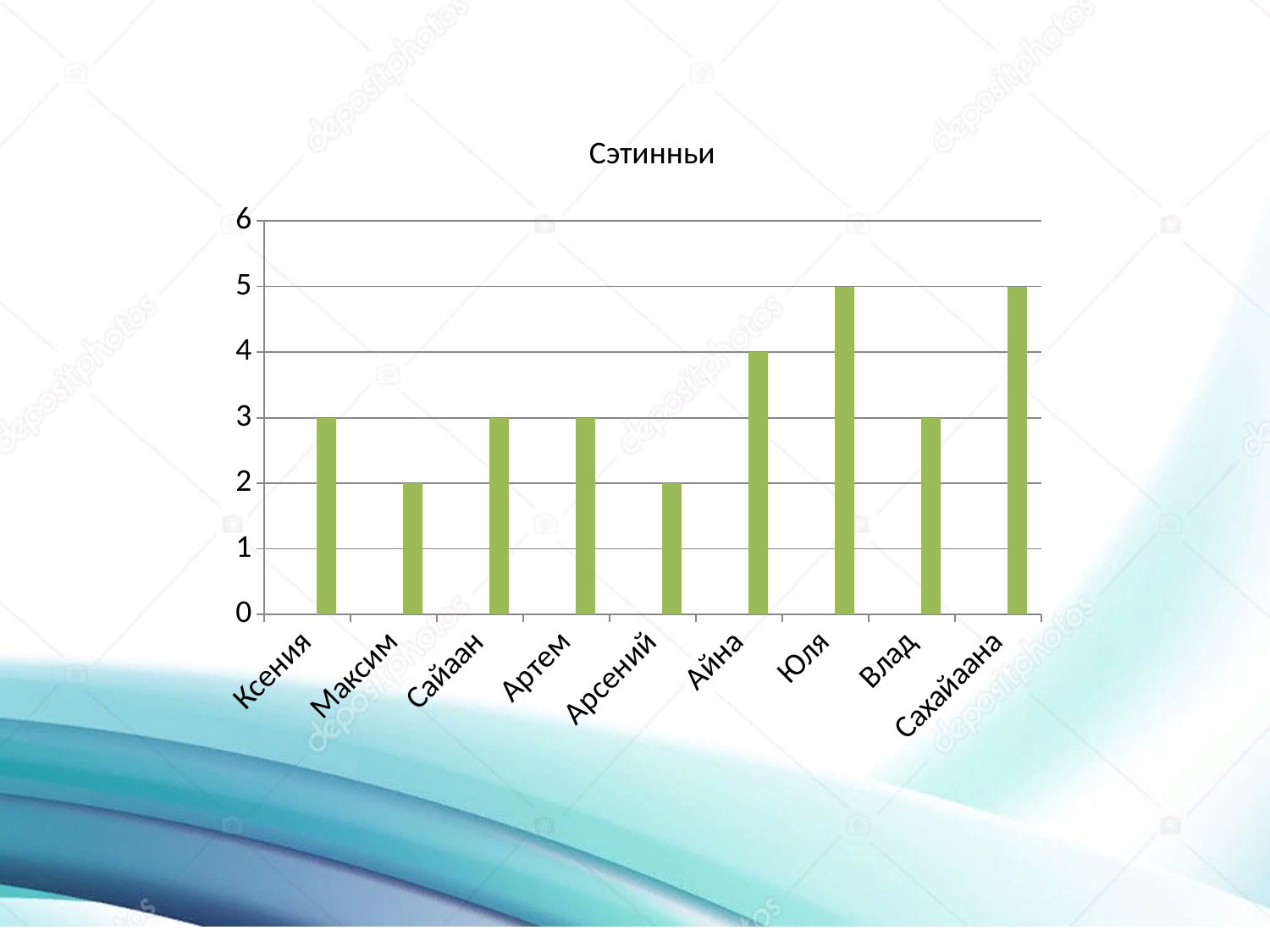
What is the value for Юля? 5 What is the difference between the values for Юля and Арсений? 3 What kind of chart is shown on the slide? Bar chart What is the value for Айна? 4 Which is larger, the value for Максим or the value for Сайаан? Сайаан Is the value for Юля greater or less than 4? greater What is the difference between the values for Айна and Влад? 1 Which is larger, the value for Айна or the value for Артем? Айна How many categories are shown on the x axis? 9 What is the value for Максим? 2 What is the value for Ксения? 3 What is the value for Сахайаана? 5